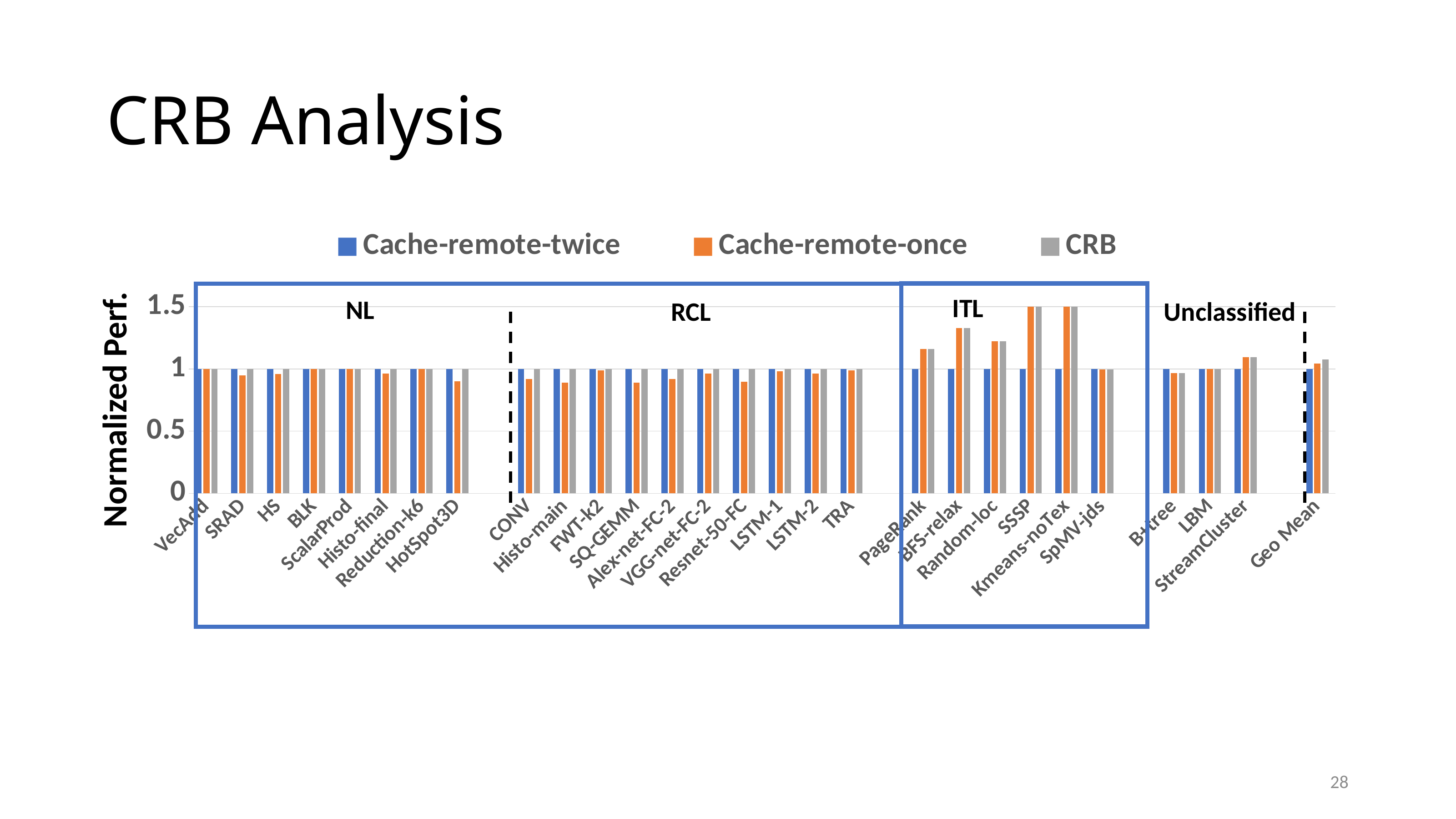
What is the label of the y axis? Normalized Perf. Is the Cache-remote-once value for SSSP greater or less than 1? greater How many series does the legend list? 3 Is the CRB value for Kmeans-noTex greater or less than 1? greater Which has the larger CRB value, SSSP or Random-loc? SSSP How many categories are shown along the x axis? 28 Which has the larger Cache-remote-once value, BFS-relax or PageRank? BFS-relax What is the Cache-remote-twice value for VecAdd? 1 Is the Cache-remote-once value for Alex-net-FC-2 greater or less than 1? less Which series is shown in orange in the legend? Cache-remote-once What kind of chart is shown on the slide? bar chart